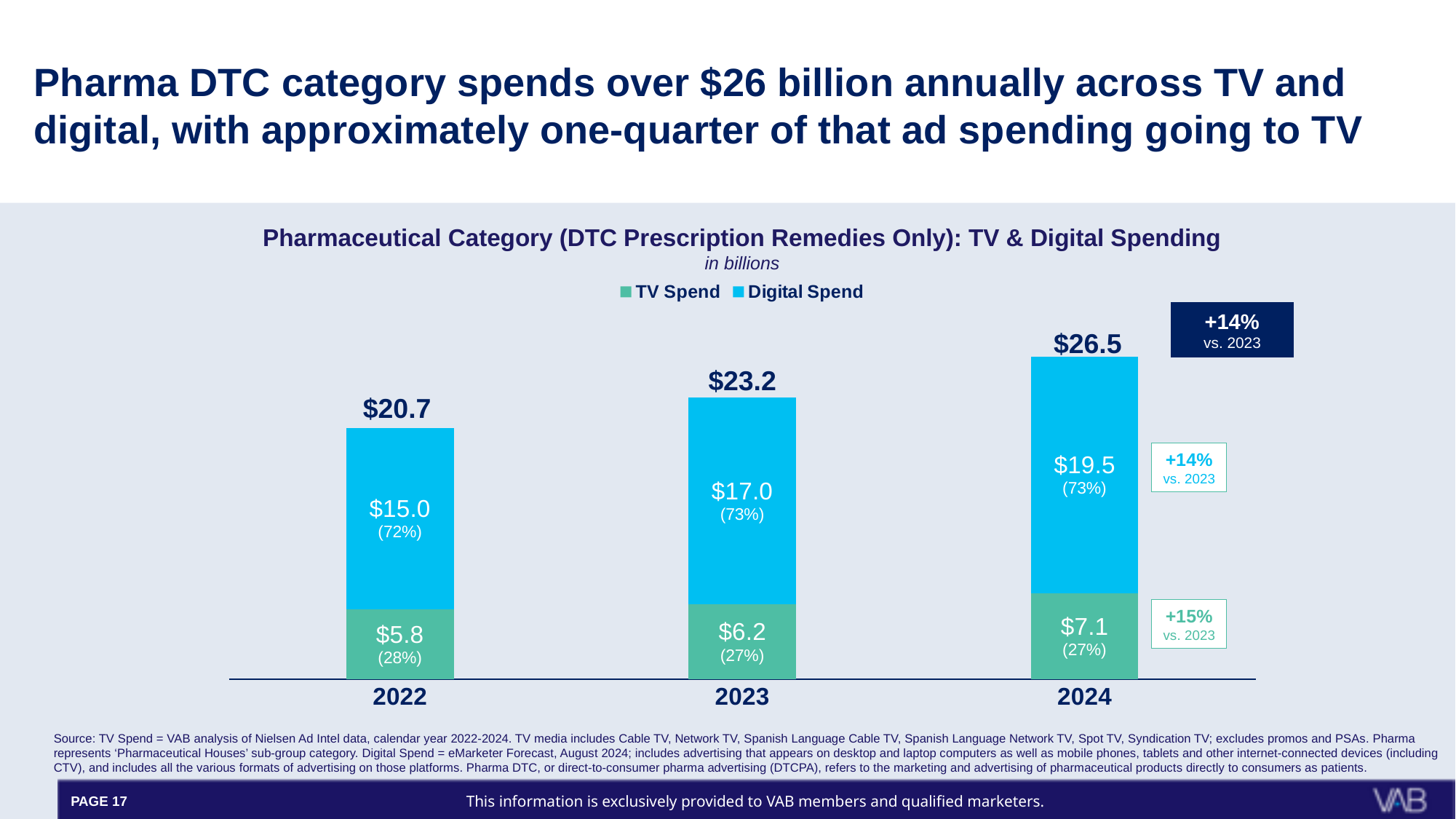
What is the Digital Spend value for 2024? $19.5 How many years are shown on the x axis? 3 What percentage share of 2024 spending does TV Spend represent? 27% What kind of chart is shown? Stacked bar chart Which year has the highest total spending? 2024 Which is larger in 2023: TV Spend or Digital Spend? Digital Spend What is the TV Spend value for 2022? $5.8 What is the total spending shown for 2023? $23.2 Does total spending rise or fall from 2022 to 2024? Rise How many series does the legend list? 2 What is the difference between Digital Spend in 2024 and Digital Spend in 2023? $2.5 Which year has the lowest TV Spend? 2022